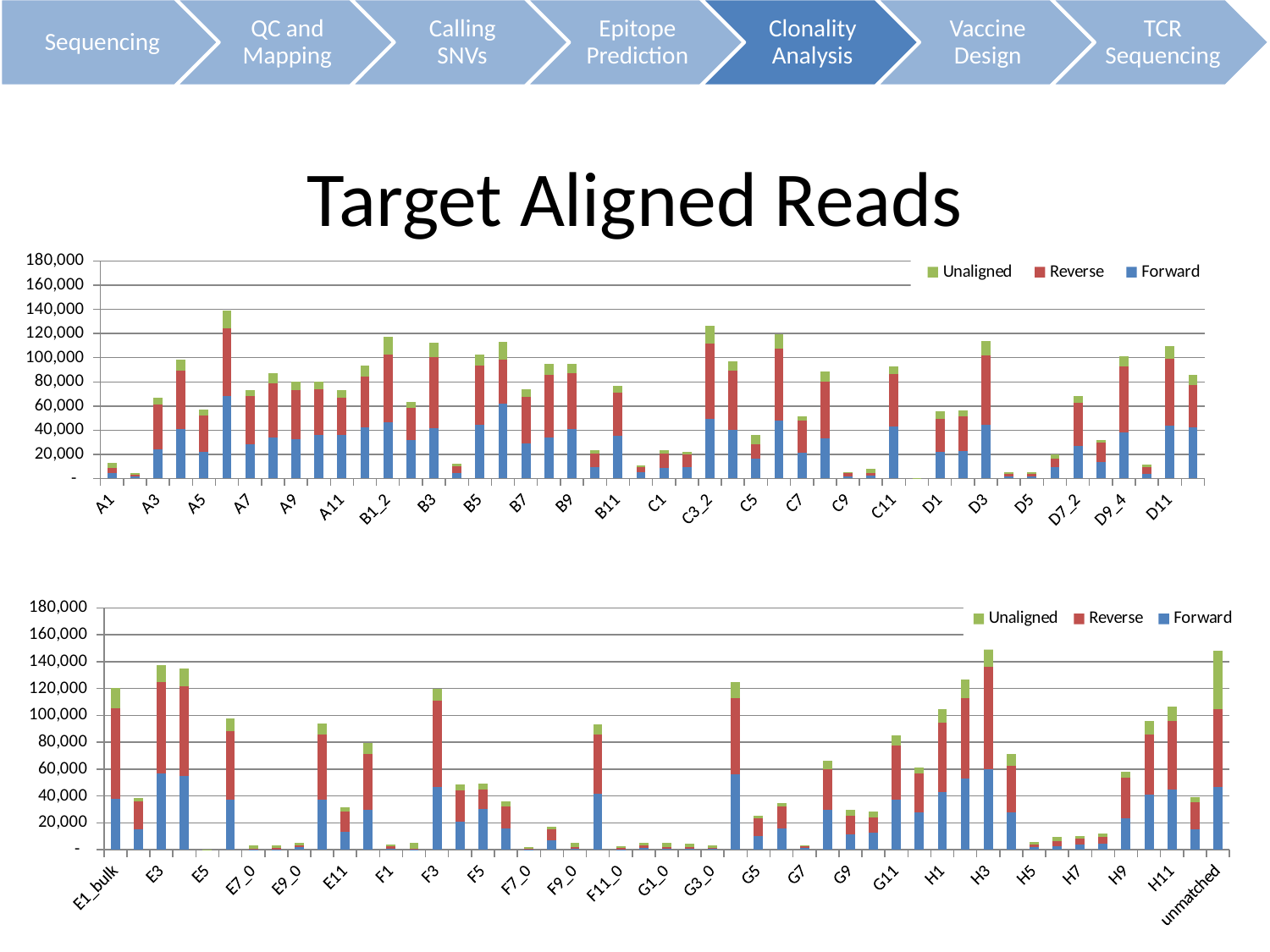
In the top chart, is the total value for A1 greater or less than 20,000? less What type of chart is used on this slide? stacked bar chart In the bottom chart, is the total value for H3 greater or less than 140,000? greater In the bottom chart, which has the larger total, F3 or F1? F3 In the bottom chart, is the total value for E5 greater or less than 20,000? less What is the title of the charts on this slide? Target Aligned Reads What are the legend entries of the bottom chart? Unaligned, Reverse, Forward In the top chart, which has the larger total, A3 or A1? A3 How many series does the legend of the top chart list? 3